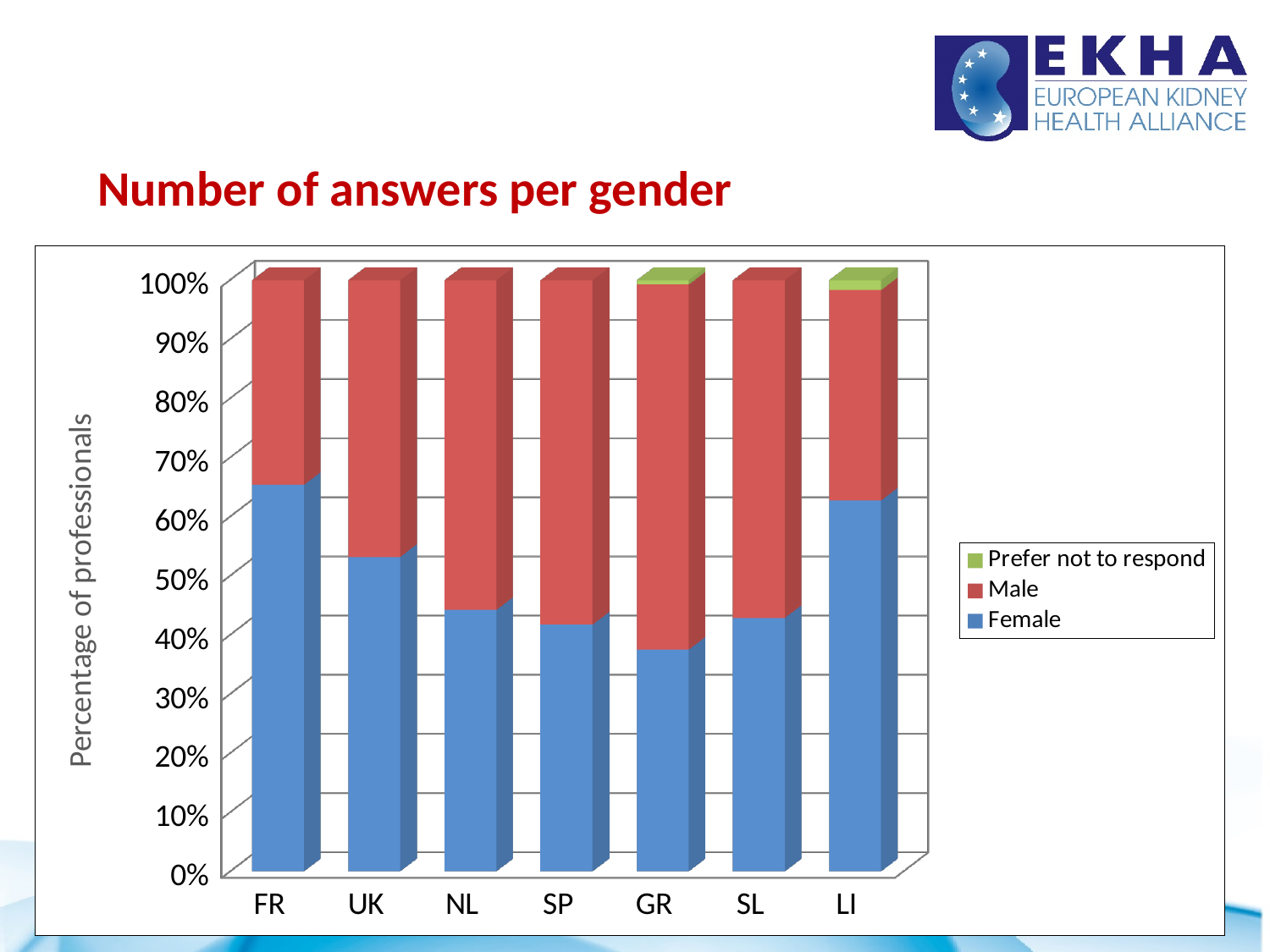
How many countries are shown on the x axis of the chart? 7 What kind of chart is shown on the slide? Stacked bar chart Is the Female share for GR greater or less than 40%? less Which colour represents Female in the chart? Blue How many countries show a visible 'Prefer not to respond' segment? 2 Is the Female share for SP greater or less than 50%? less Is the Female share for FR greater or less than 60%? greater How many series does the chart's legend list? 3 Which country has the largest Male share? GR What is the title of the chart on the slide? Number of answers per gender Which has the larger Female share, FR or GR? FR